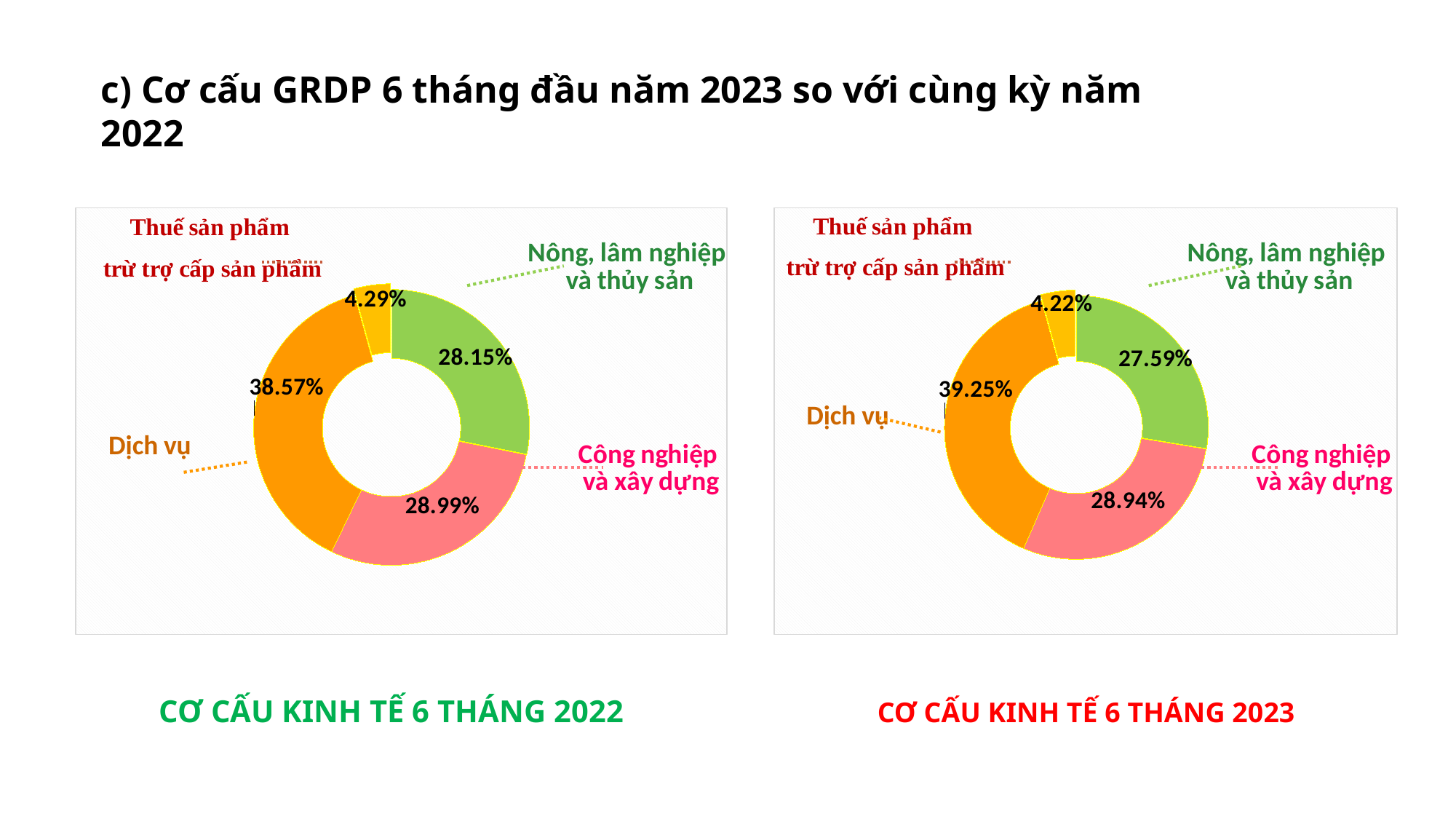
In the chart titled 'CƠ CẤU KINH TẾ 6 THÁNG 2022', what is the difference between the shares of 'Dịch vụ' and 'Công nghiệp và xây dựng'? 9.58% In the chart titled 'CƠ CẤU KINH TẾ 6 THÁNG 2023', what is the value for 'Công nghiệp và xây dựng'? 28.94% In the chart titled 'CƠ CẤU KINH TẾ 6 THÁNG 2023', what is the difference between the shares of 'Công nghiệp và xây dựng' and 'Nông, lâm nghiệp và thủy sản'? 1.35% Is the share of 'Dịch vụ' larger in the 2022 chart or the 2023 chart? 2023 How many categories does the chart titled 'CƠ CẤU KINH TẾ 6 THÁNG 2022' show? 4 In the chart titled 'CƠ CẤU KINH TẾ 6 THÁNG 2022', what share does 'Dịch vụ' have? 38.57% In the chart titled 'CƠ CẤU KINH TẾ 6 THÁNG 2022', what colour is the 'Công nghiệp và xây dựng' slice? Pink What type of chart is the chart titled 'CƠ CẤU KINH TẾ 6 THÁNG 2023'? Doughnut chart In the chart titled 'CƠ CẤU KINH TẾ 6 THÁNG 2023', which category has the largest share? Dịch vụ In the chart titled 'CƠ CẤU KINH TẾ 6 THÁNG 2023', what share does 'Nông, lâm nghiệp và thủy sản' have? 27.59% In the chart titled 'CƠ CẤU KINH TẾ 6 THÁNG 2022', which category has the smallest share? Thuế sản phẩm trừ trợ cấp sản phẩm In the chart titled 'CƠ CẤU KINH TẾ 6 THÁNG 2022', what is the value for 'Thuế sản phẩm trừ trợ cấp sản phẩm'? 4.29%